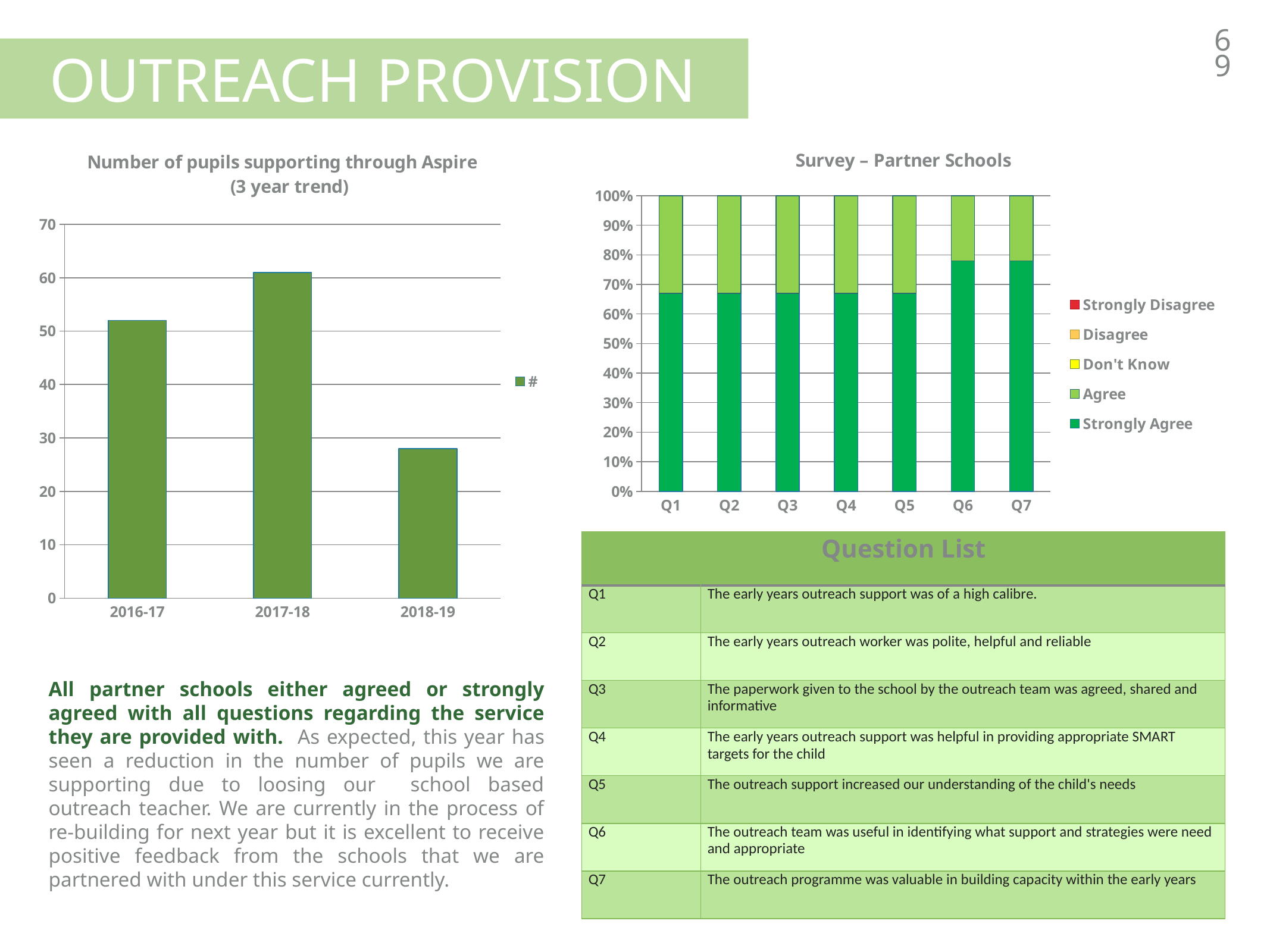
What kind of chart is the 'Number of pupils supporting through Aspire (3 year trend)' chart? bar chart In the 'Number of pupils supporting through Aspire (3 year trend)' chart, is the value for 2018-19 greater or less than 40? less How many categories are shown on the x axis of the 'Number of pupils supporting through Aspire (3 year trend)' chart? 3 In the 'Number of pupils supporting through Aspire (3 year trend)' chart, which year has the lowest value? 2018-19 In the 'Number of pupils supporting through Aspire (3 year trend)' chart, which year has the highest value? 2017-18 In the 'Number of pupils supporting through Aspire (3 year trend)' chart, is the value for 2016-17 greater or less than 40? greater In the 'Survey – Partner Schools' chart, which has the larger Strongly Agree share, Q1 or Q7? Q7 In the 'Survey – Partner Schools' chart, is the Strongly Agree share for Q6 greater or less than 70%? greater How many series does the legend of the 'Survey – Partner Schools' chart list? 5 How many questions are shown on the x axis of the 'Survey – Partner Schools' chart? 7 In the 'Number of pupils supporting through Aspire (3 year trend)' chart, which is larger, the value for 2017-18 or 2018-19? 2017-18 What kind of chart is the 'Survey – Partner Schools' chart? stacked bar chart